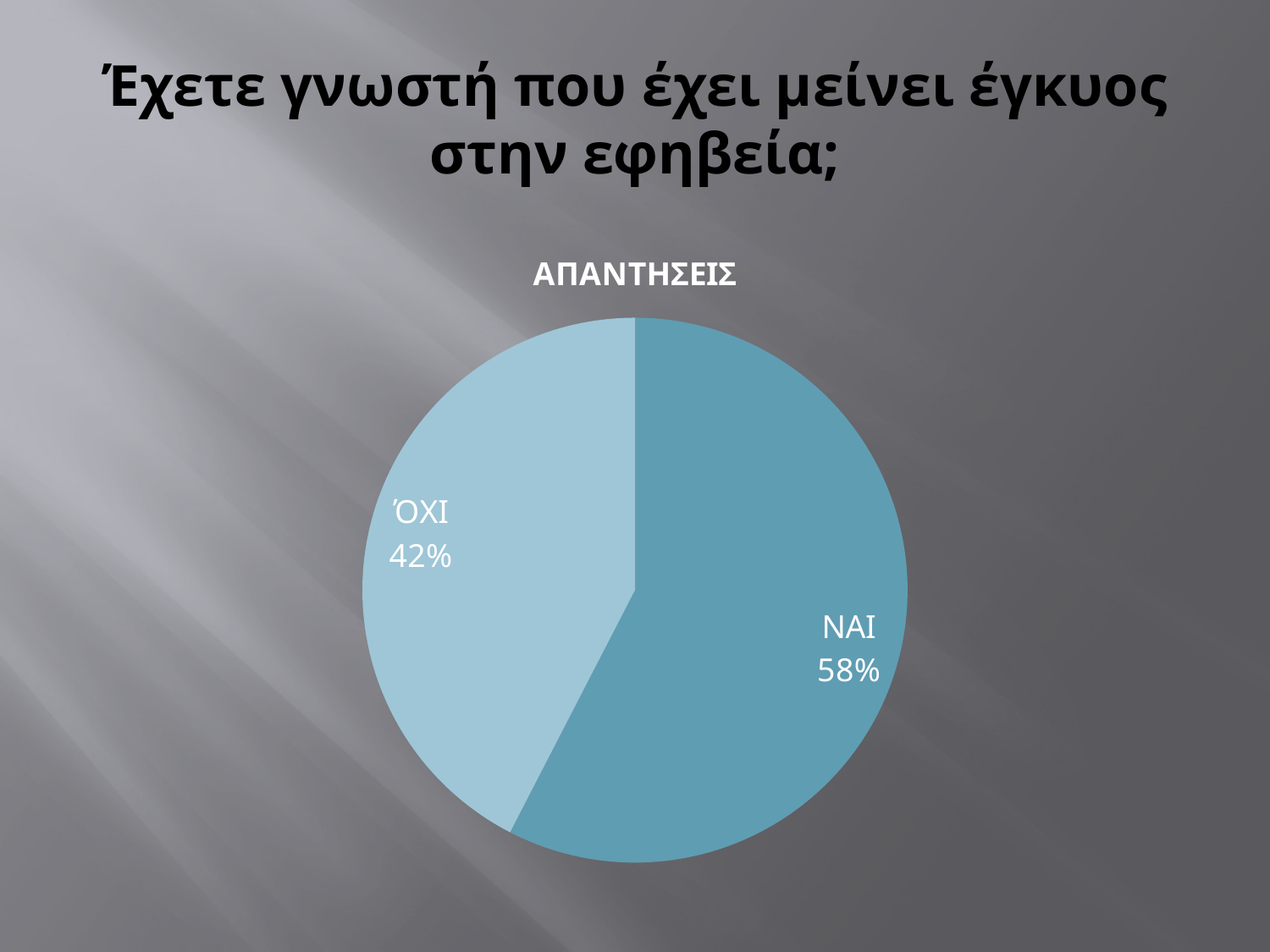
What is the title of the chart? ΑΠΑΝΤΗΣΕΙΣ What percentage of the pie is the ΌΧΙ slice? 42% How many slices does the pie chart have? 2 What is the difference in percentage points between the ΝΑΙ and ΌΧΙ slices? 16 Which is larger, the ΝΑΙ slice or the ΌΧΙ slice? ΝΑΙ Which slice is the largest in the pie chart? ΝΑΙ What percentage of the pie is the ΝΑΙ slice? 58% What kind of chart is shown on the slide? pie chart Which slice of the pie chart is the lighter blue colour? ΌΧΙ Which slice is the smallest in the pie chart? ΌΧΙ What share of the pie does the ΝΑΙ slice represent? 58%